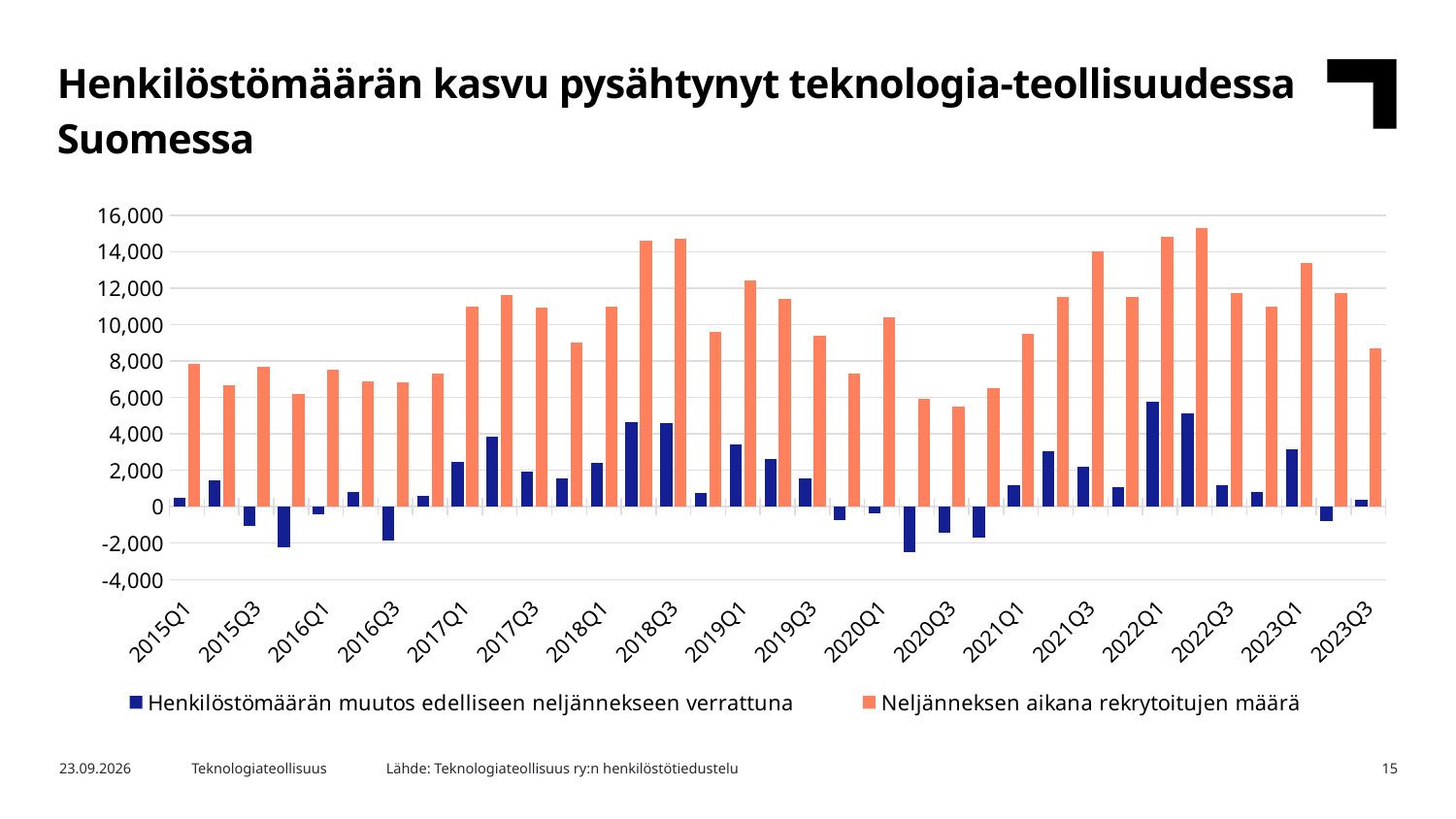
Is the value of Henkilöstömäärän muutos edelliseen neljännekseen verrattuna for 2022Q1 greater or less than 4,000? greater Which series is drawn in orange? Neljänneksen aikana rekrytoitujen määrä What is the title of the slide containing the chart? Henkilöstömäärän kasvu pysähtynyt teknologia-teollisuudessa Suomessa Which quarter has the highest value of Henkilöstömäärän muutos edelliseen neljännekseen verrattuna? 2022Q1 Is the value of Neljänneksen aikana rekrytoitujen määrä for 2015Q1 greater or less than 6,000? greater Is the value of Henkilöstömäärän muutos edelliseen neljännekseen verrattuna for 2020Q2 greater or less than -2,000? less What kind of chart is shown on the slide? Bar chart Which is larger for Neljänneksen aikana rekrytoitujen määrä: 2017Q1 or 2015Q1? 2017Q1 How many series does the legend list? 2 How many quarter labels are shown on the x axis? 18